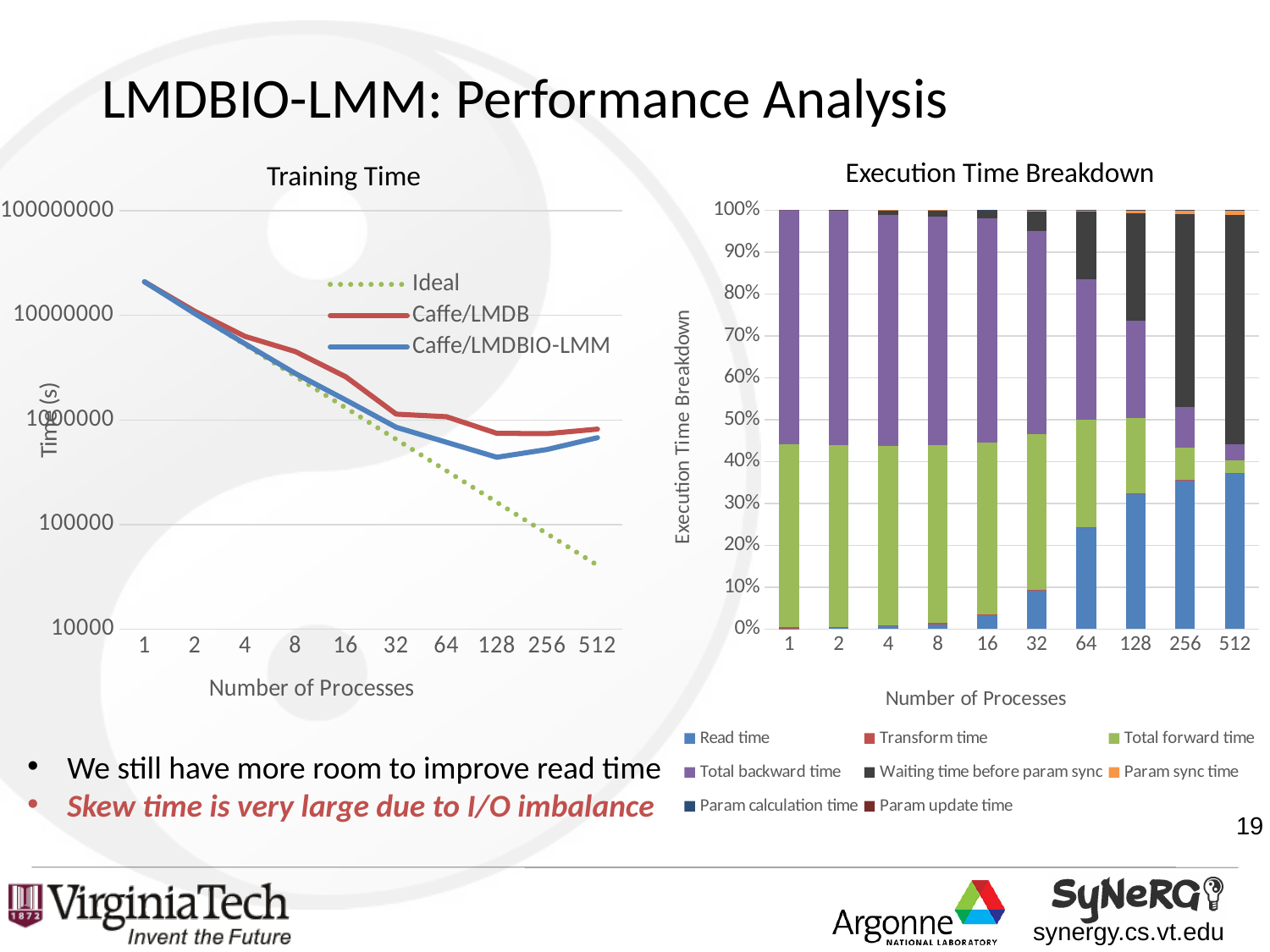
In the Training Time chart, is the Ideal value at 512 processes greater or less than 100000? less How many series does the legend of the Execution Time Breakdown chart list? 8 How many Number of Processes categories are shown on the x axis of the Execution Time Breakdown chart? 10 In the Training Time chart, do the training times rise or fall as the number of processes increases? Fall In the Execution Time Breakdown chart, does the Read time share rise or fall as the number of processes increases? Rise In the Execution Time Breakdown chart, which number of processes has the largest Read time share? 512 In the Training Time chart, is the Caffe/LMDBIO-LMM value at 128 processes greater or less than 1000000? less What kind of chart is the Execution Time Breakdown chart? Stacked bar chart In the Execution Time Breakdown chart, is the Read time share at 512 processes greater or less than 30%? greater In the Training Time chart, at 512 processes, which series has the larger value: Caffe/LMDB or Caffe/LMDBIO-LMM? Caffe/LMDB What kind of chart is the Training Time chart? Line chart How many series does the legend of the Training Time chart list? 3